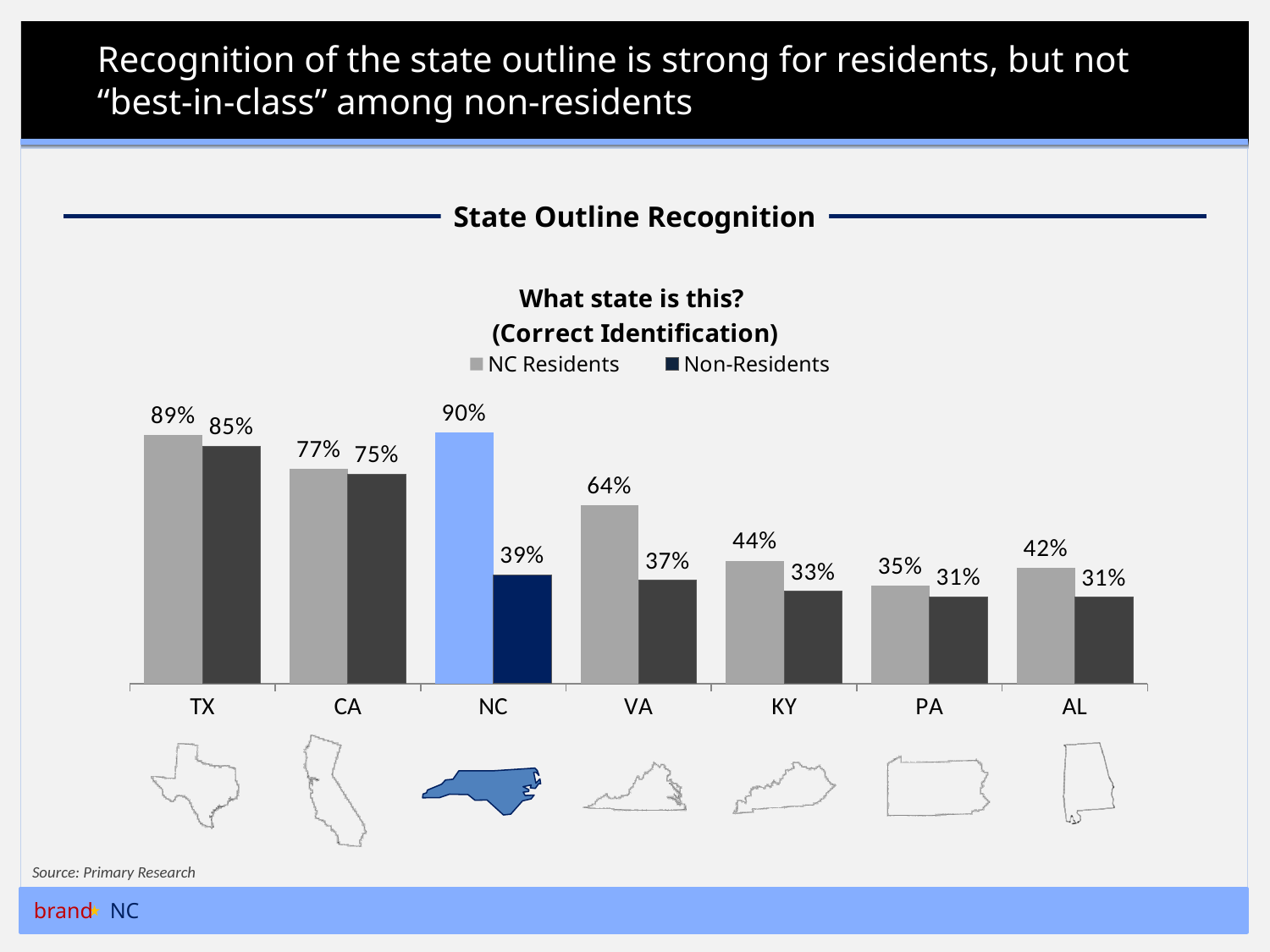
Which state has the lowest Non-Residents value? PA and AL (31%) Which state's bars are highlighted in blue rather than grey? NC Which is larger: the Non-Residents value for TX or the Non-Residents value for CA? TX What is the Non-Residents value for VA? 37% How many series does the legend list? 2 What percentage of NC Residents correctly identified the NC state outline? 90% What percentage of Non-Residents correctly identified the NC state outline? 39% Which state has the highest NC Residents value? NC How many states are shown on the x axis of the chart? 7 What is the difference between the NC Residents values for TX and KY? 45 percentage points What kind of chart is shown on the slide? Bar chart What is the difference between the NC Residents and Non-Residents values for NC? 51 percentage points